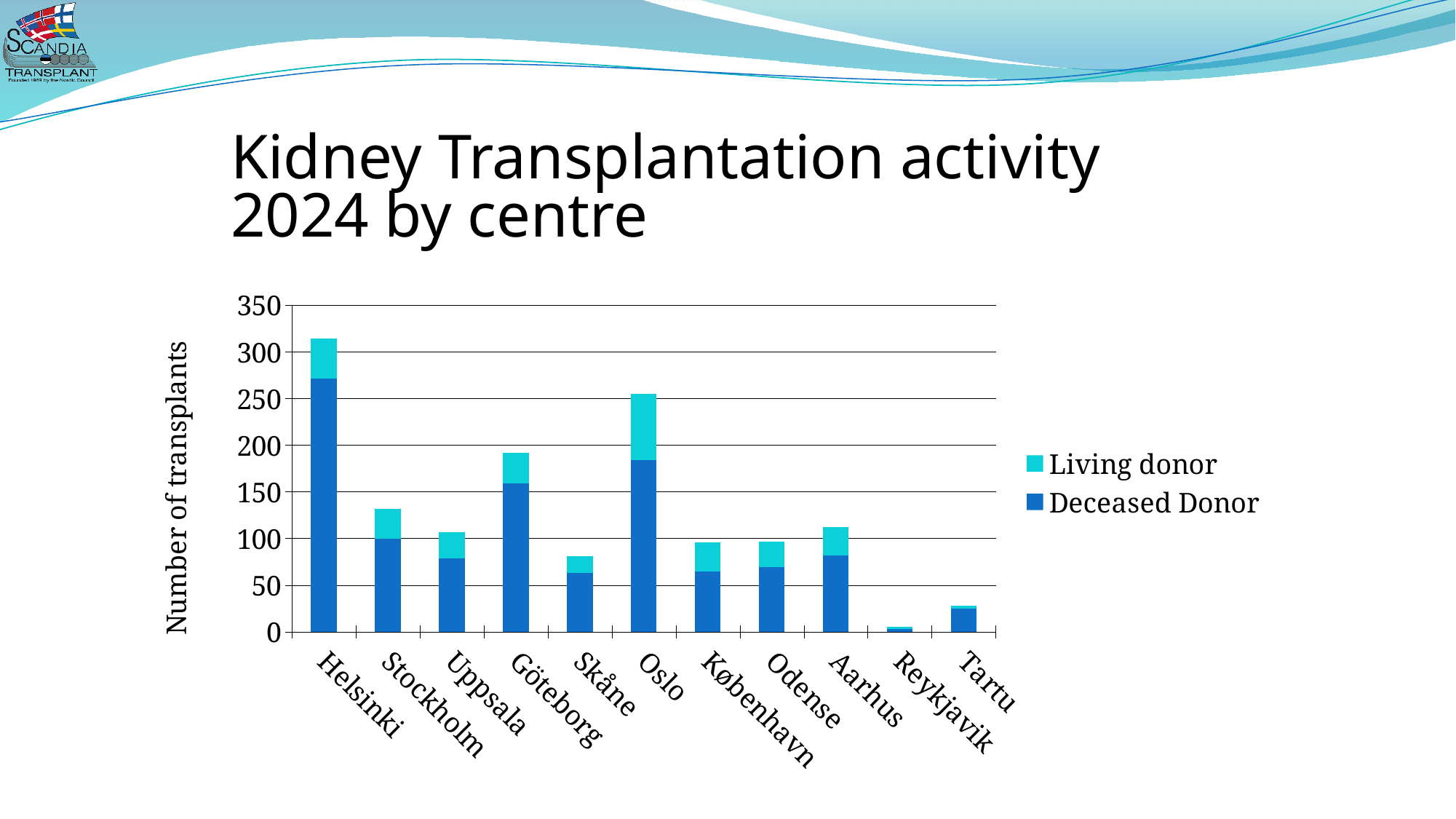
What is the label of the y axis? Number of transplants Is the total number of transplants for Tartu greater or less than 50? less Is the Deceased Donor value for Oslo greater or less than 200? less Which centre has a higher total number of transplants, Stockholm or Uppsala? Stockholm What kind of chart is shown on the slide? Stacked bar chart Which centre has the lowest total number of transplants? Reykjavik Is the total number of transplants for Helsinki greater or less than 300? greater Which centre has a higher total number of transplants, Oslo or Göteborg? Oslo Which centre has the highest total number of transplants? Helsinki How many series does the legend list? 2 How many centres are shown on the x axis of the chart? 11